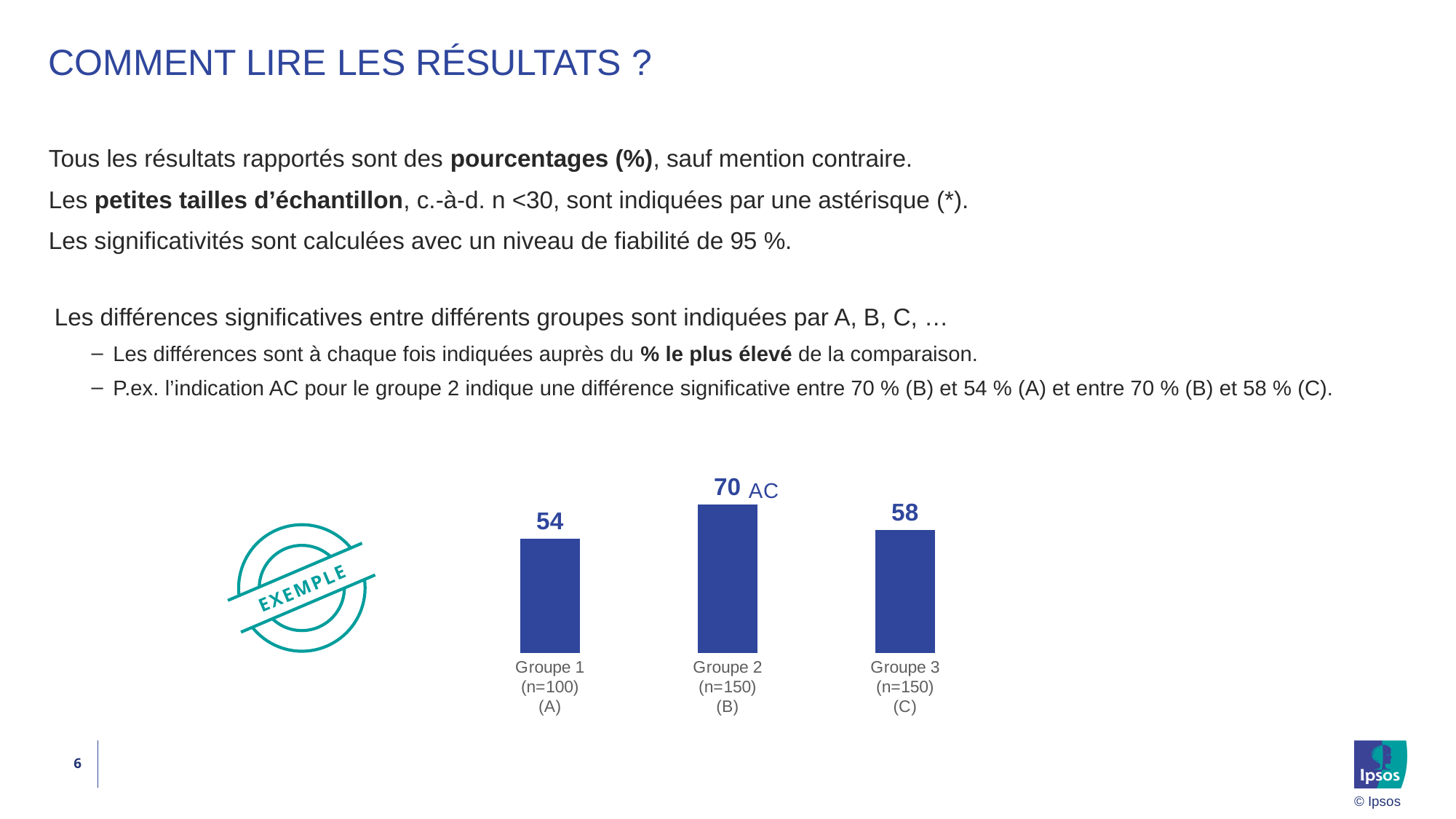
Which group has the highest value? Groupe 2 What is the sample size (n) shown for Groupe 1? n=100 What is the value for Groupe 1 (n=100) (A)? 54 What is the difference between the values for Groupe 2 and Groupe 1? 16 Which group has the lowest value? Groupe 1 What is the value for Groupe 3 (n=150) (C)? 58 What kind of chart is shown on the slide? Bar chart Which bar carries the significance annotation 'AC'? Groupe 2 How many groups are shown in the chart? 3 What is the difference between the values for Groupe 3 and Groupe 1? 4 Which is larger, the value for Groupe 3 or the value for Groupe 1? Groupe 3 What is the value for Groupe 2 (n=150) (B)? 70